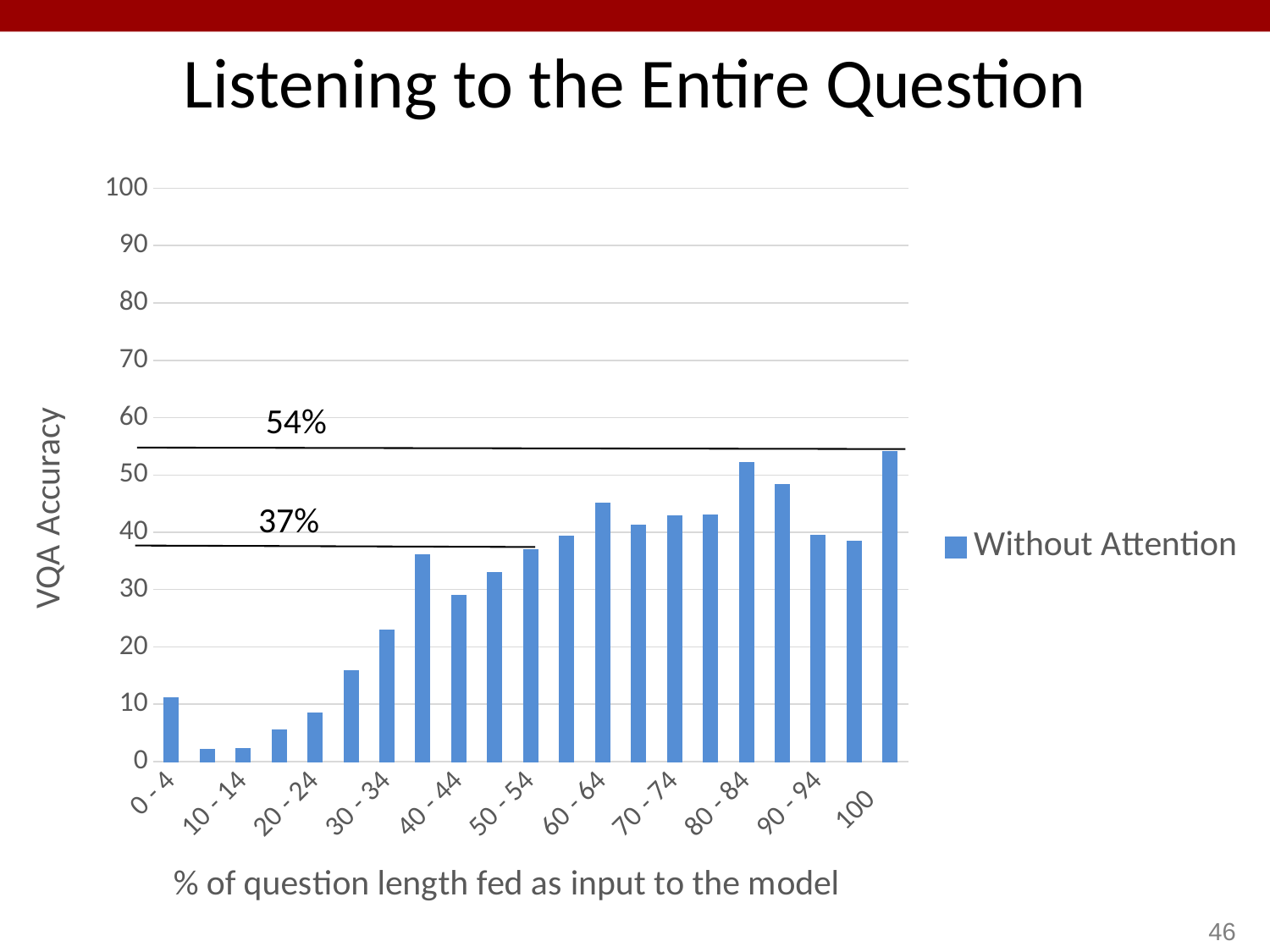
Is the VQA Accuracy for the 0 - 4 category greater or less than 20? less Is the VQA Accuracy for the 60 - 64 category greater or less than 40? greater Do the VQA Accuracy values generally rise or fall as the % of question length increases? rise How many series does the legend list? 1 Which has a higher VQA Accuracy, the 60 - 64 category or the 50 - 54 category? 60 - 64 What is the name of the series shown in the legend? Without Attention What value is annotated on the upper horizontal line in the chart? 54% What is the label of the vertical axis? VQA Accuracy Which category has the highest VQA Accuracy? 100 How many bars are plotted in the chart? 21 What value is annotated on the lower horizontal line in the chart? 37% What kind of chart is shown on the slide? bar chart